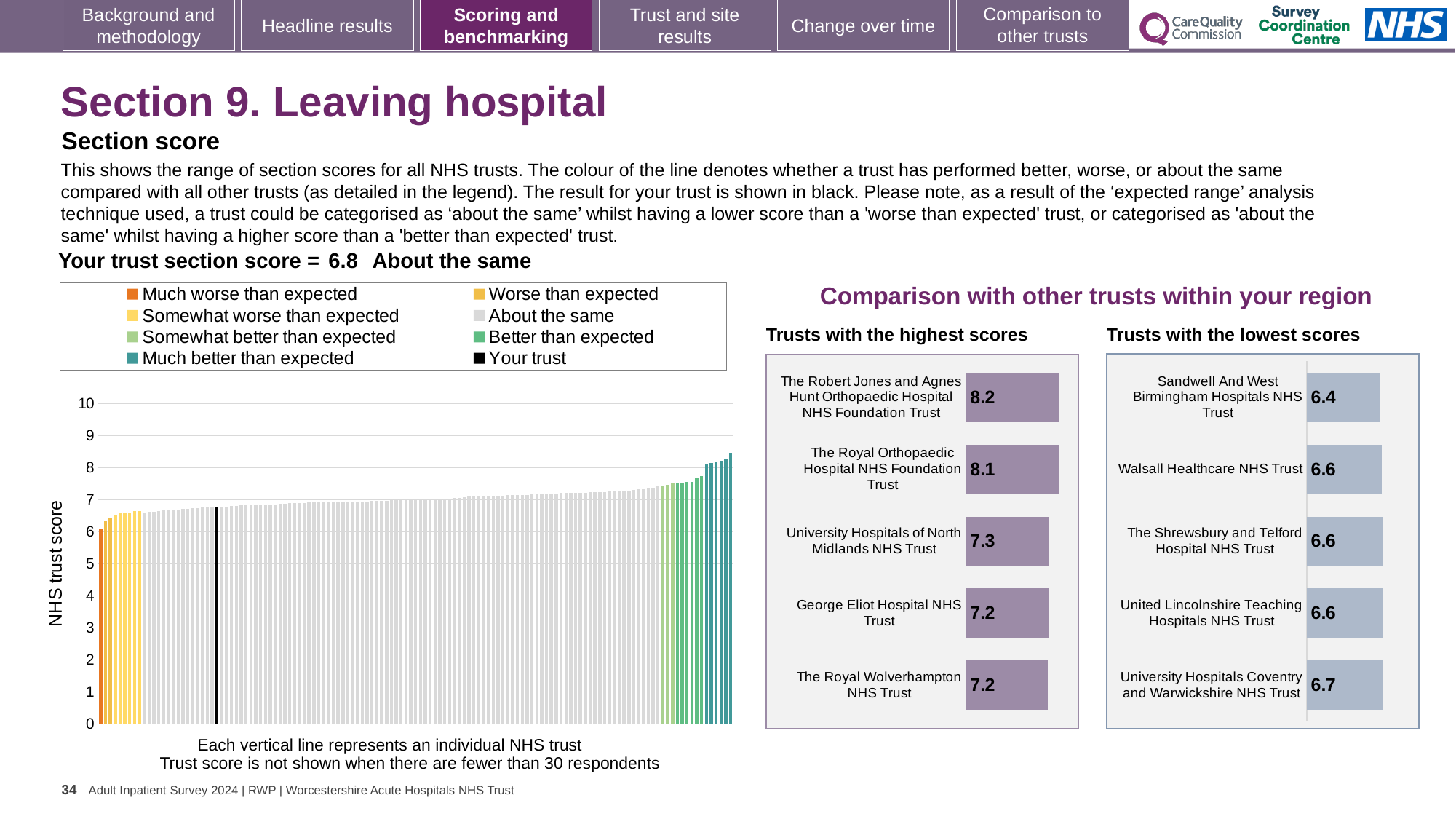
Which has a higher score: The Royal Orthopaedic Hospital NHS Foundation Trust in the highest scores chart, or Walsall Healthcare NHS Trust in the lowest scores chart? The Royal Orthopaedic Hospital NHS Foundation Trust In the 'Trusts with the lowest scores' chart, what is the score for University Hospitals Coventry and Warwickshire NHS Trust? 6.7 In the 'Trusts with the lowest scores' chart, which trust has the lowest score? Sandwell And West Birmingham Hospitals NHS Trust In the 'Trusts with the highest scores' chart, which trust has the highest score? The Robert Jones and Agnes Hunt Orthopaedic Hospital NHS Foundation Trust What type of chart is the 'Trusts with the lowest scores' chart? Bar chart How many trusts are shown in the 'Trusts with the highest scores' chart? 5 In the 'Trusts with the lowest scores' chart, what is the difference between the scores of University Hospitals Coventry and Warwickshire NHS Trust and Sandwell And West Birmingham Hospitals NHS Trust? 0.3 In the 'Trusts with the lowest scores' chart, what is the score for Sandwell And West Birmingham Hospitals NHS Trust? 6.4 In the main NHS trust score chart, how many entries does the legend list? 8 In the 'Trusts with the highest scores' chart, what is the difference between the scores of The Robert Jones and Agnes Hunt Orthopaedic Hospital NHS Foundation Trust and The Royal Wolverhampton NHS Trust? 1.0 In the 'Trusts with the highest scores' chart, what is the score for The Robert Jones and Agnes Hunt Orthopaedic Hospital NHS Foundation Trust? 8.2 In the 'Trusts with the highest scores' chart, what is the score for University Hospitals of North Midlands NHS Trust? 7.3